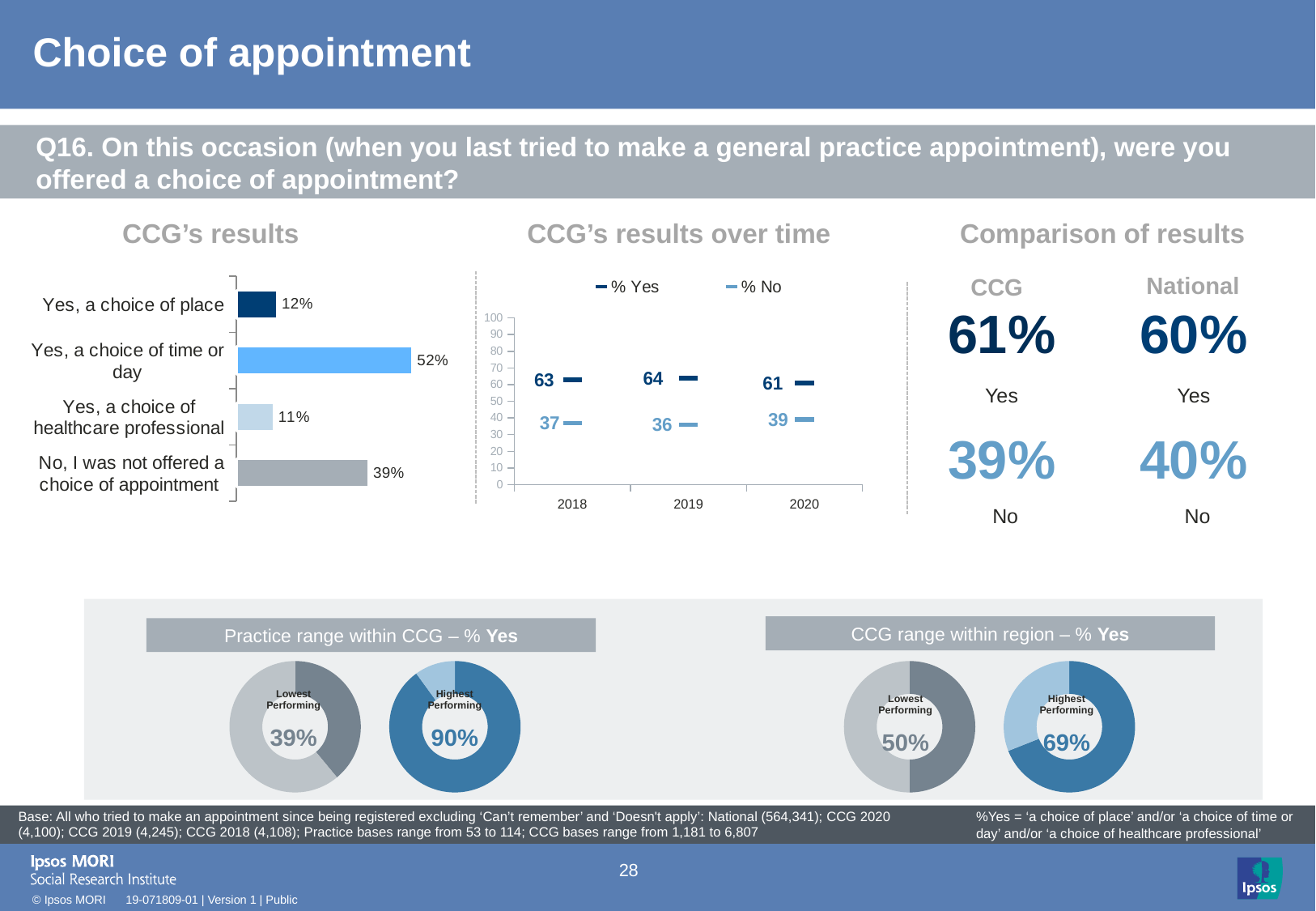
In the 'Practice range within CCG – % Yes' section, what is the 'Highest Performing' value? 90% What kind of chart is the 'CCG's results' chart? Bar chart In the 'CCG's results' chart, how many categories are shown? 4 In the 'CCG's results' chart, which category has the lowest value? Yes, a choice of healthcare professional In the 'CCG's results' chart, what is the value for 'Yes, a choice of time or day'? 52% In the 'CCG's results over time' chart, what is the '% Yes' value for 2019? 64 In the 'CCG's results over time' chart, is the '% Yes' value for 2018 larger or smaller than the '% Yes' value for 2020? Larger In the 'CCG's results' chart, what is the difference between 'Yes, a choice of time or day' and 'No, I was not offered a choice of appointment'? 13% In the 'CCG's results over time' chart, what is the '% No' value for 2020? 39 In the 'CCG's results' chart, which category has the highest value? Yes, a choice of time or day In the 'CCG's results' chart, what is the value for 'No, I was not offered a choice of appointment'? 39% In the 'CCG's results over time' chart, how many series does the legend list? 2